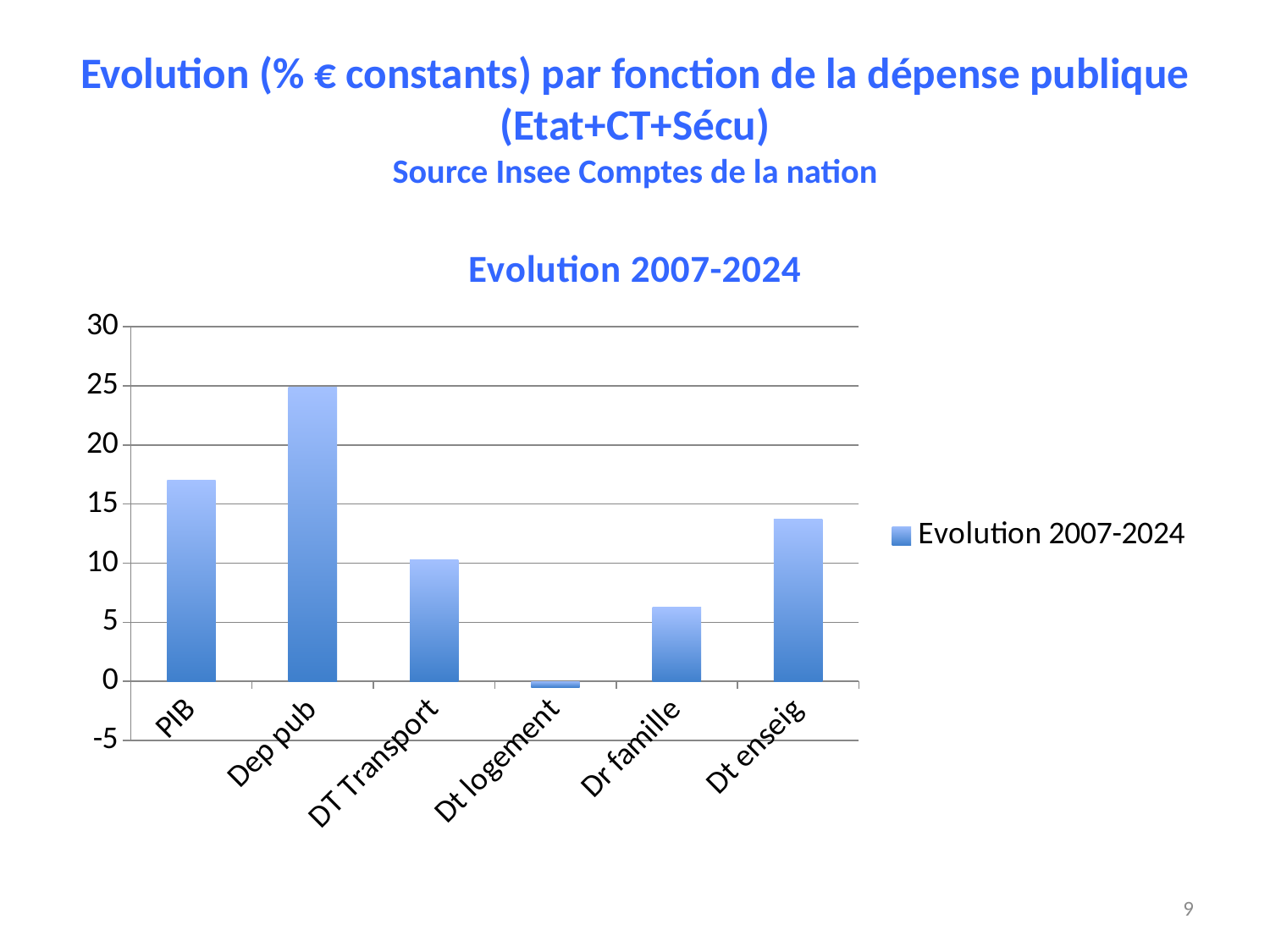
Is the value for DT Transport greater or less than 15? less Which category has the highest value in the chart? Dep pub What kind of chart is shown on the slide? bar chart How many categories are shown on the x axis of the chart? 6 How many series does the legend list? 1 Is the value for Dr famille greater or less than 5? greater What is the title of the chart? Evolution 2007-2024 Is the value for Dt logement greater or less than 0? less Which category has the lowest value in the chart? Dt logement Which is larger, the value for Dr famille or the value for DT Transport? DT Transport Which is larger, the value for PIB or the value for Dt enseig? PIB